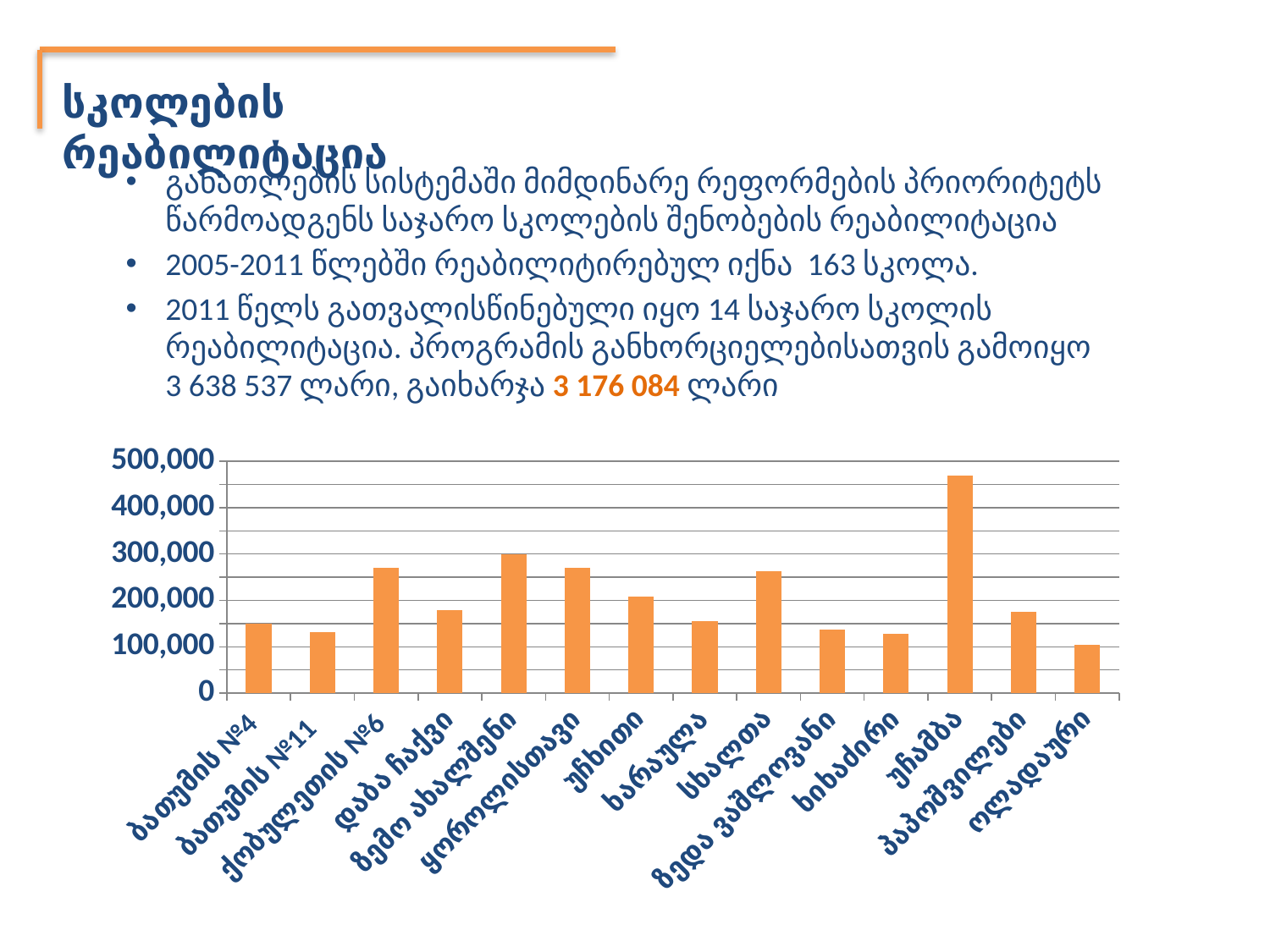
Is the value for ქობულეთის №6 greater or less than 200,000? greater What is the highest value shown on the y axis of the chart? 500,000 Which category has the lowest bar in the chart? ოლადაური Is the value for ყოროლისთავი greater or less than 200,000? greater How many categories (schools) are shown on the x axis of the chart? 14 What kind of chart is shown on the slide? bar chart Which has the larger value, ხიხაძირი or სხალთა? სხალთა Is the value for ზედა ვაშლოვანი greater or less than 100,000? greater Which has the larger value, ბათუმის №4 or ქობულეთის №6? ქობულეთის №6